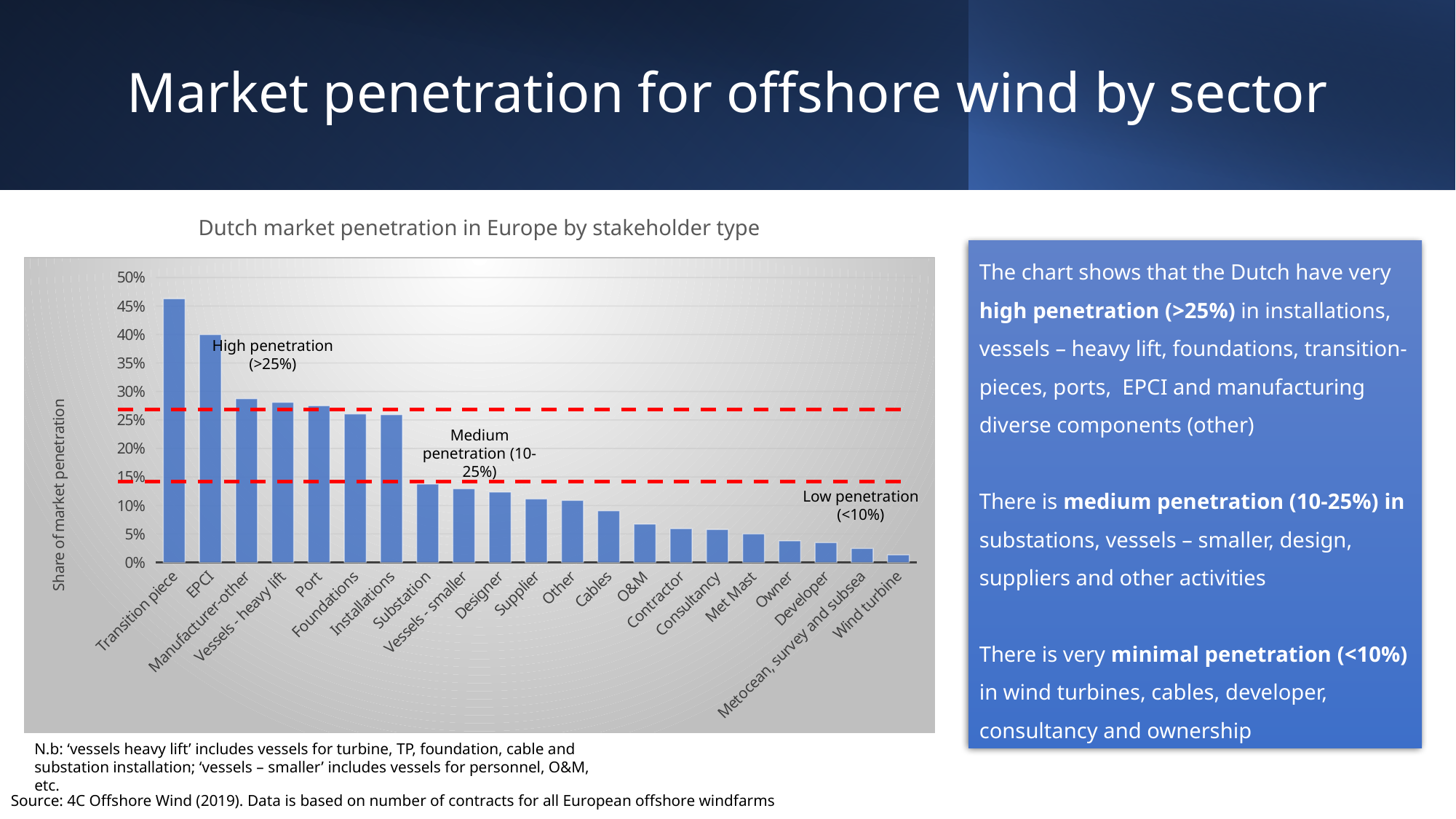
Which has a larger share of market penetration, EPCI or Port? EPCI Is the value for Transition piece greater or less than 40%? greater Which has a larger share of market penetration, Owner or Supplier? Supplier Which stakeholder type has the lowest share of market penetration? Wind turbine What is the label on the vertical axis of the chart? Share of market penetration What is the title of the chart? Dutch market penetration in Europe by stakeholder type How many stakeholder categories are plotted in the chart? 21 What kind of chart is shown on the slide? Bar chart Which stakeholder type has the highest share of market penetration? Transition piece Is the value for Cables greater or less than 10%? less Do the values rise or fall moving from left to right along the x axis? Fall Is the value for Substation greater or less than 10%? greater